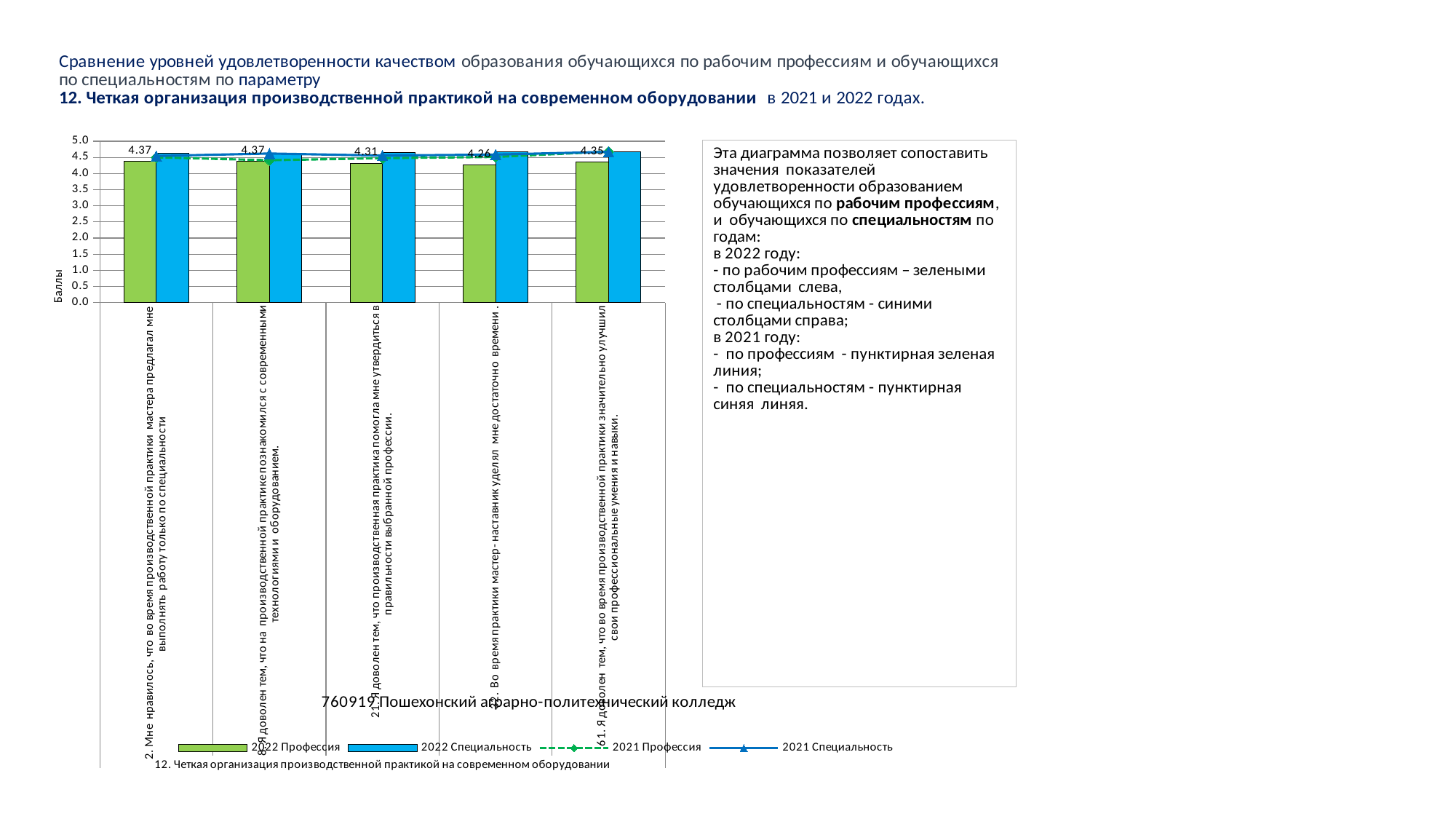
What is the value of the 2022 Профессия bar for category 2 (Мне нравилось, что во время производственной практики мастера предлагал мне выполнять работу только по специальности)? 4.37 What is the title of the vertical axis? Баллы Which category has the lowest 2022 Профессия value? 32. Во время практики мастер-наставник уделял мне достаточно времени How many categories (questions) are shown on the x axis? 5 What kind of chart is shown on the slide? bar chart (with line series) Is the 2022 Специальность bar for category 2 greater or less than 4.0? greater Which has the larger 2022 Профессия value: category 21 or category 61? 61 How many series does the legend list? 4 What is the value of the 2022 Профессия bar for category 61 (Я доволен тем, что во время производственной практики значительно улучшил свои профессиональные умения и навыки)? 4.35